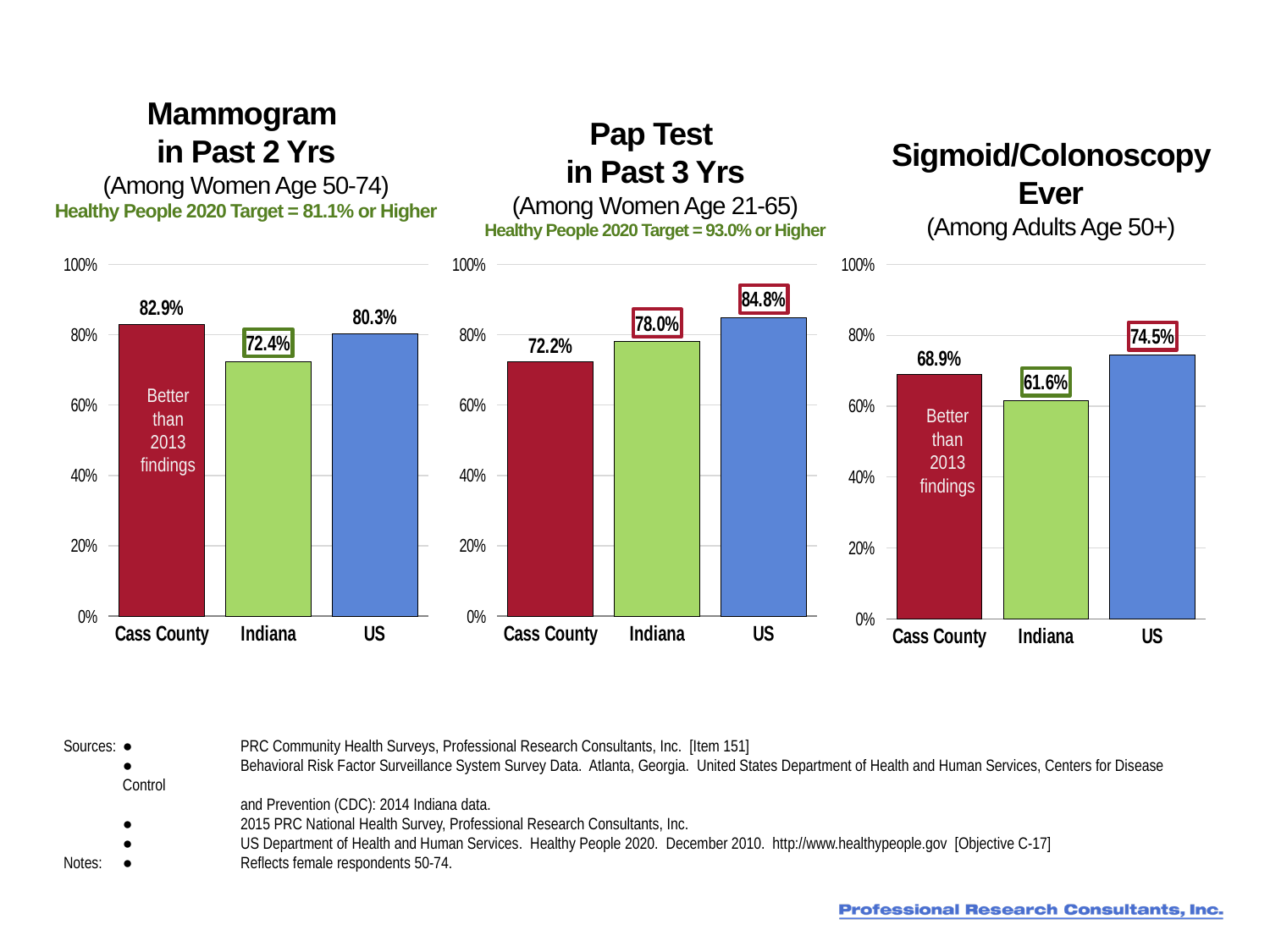
In the Mammogram in Past 2 Yrs chart, what is the difference between the Cass County and US values? 2.6% How many categories are shown in the Sigmoid/Colonoscopy Ever chart? 3 What kind of chart is the Mammogram in Past 2 Yrs chart? bar chart In the Mammogram in Past 2 Yrs chart, what is the value for Cass County? 82.9% In the Pap Test in Past 3 Yrs chart, do the values rise or fall from Cass County to US? rise In the Sigmoid/Colonoscopy Ever chart, what is the value for US? 74.5% In the Pap Test in Past 3 Yrs chart, what is the value for Indiana? 78.0% In the Sigmoid/Colonoscopy Ever chart, which is larger, Cass County or Indiana? Cass County In the Pap Test in Past 3 Yrs chart, which category has the highest value? US In the Mammogram in Past 2 Yrs chart, which category has the lowest value? Indiana In the Sigmoid/Colonoscopy Ever chart, what is the difference between the US and Indiana values? 12.9% What is the Healthy People 2020 Target stated for the Pap Test in Past 3 Yrs chart? 93.0% or Higher